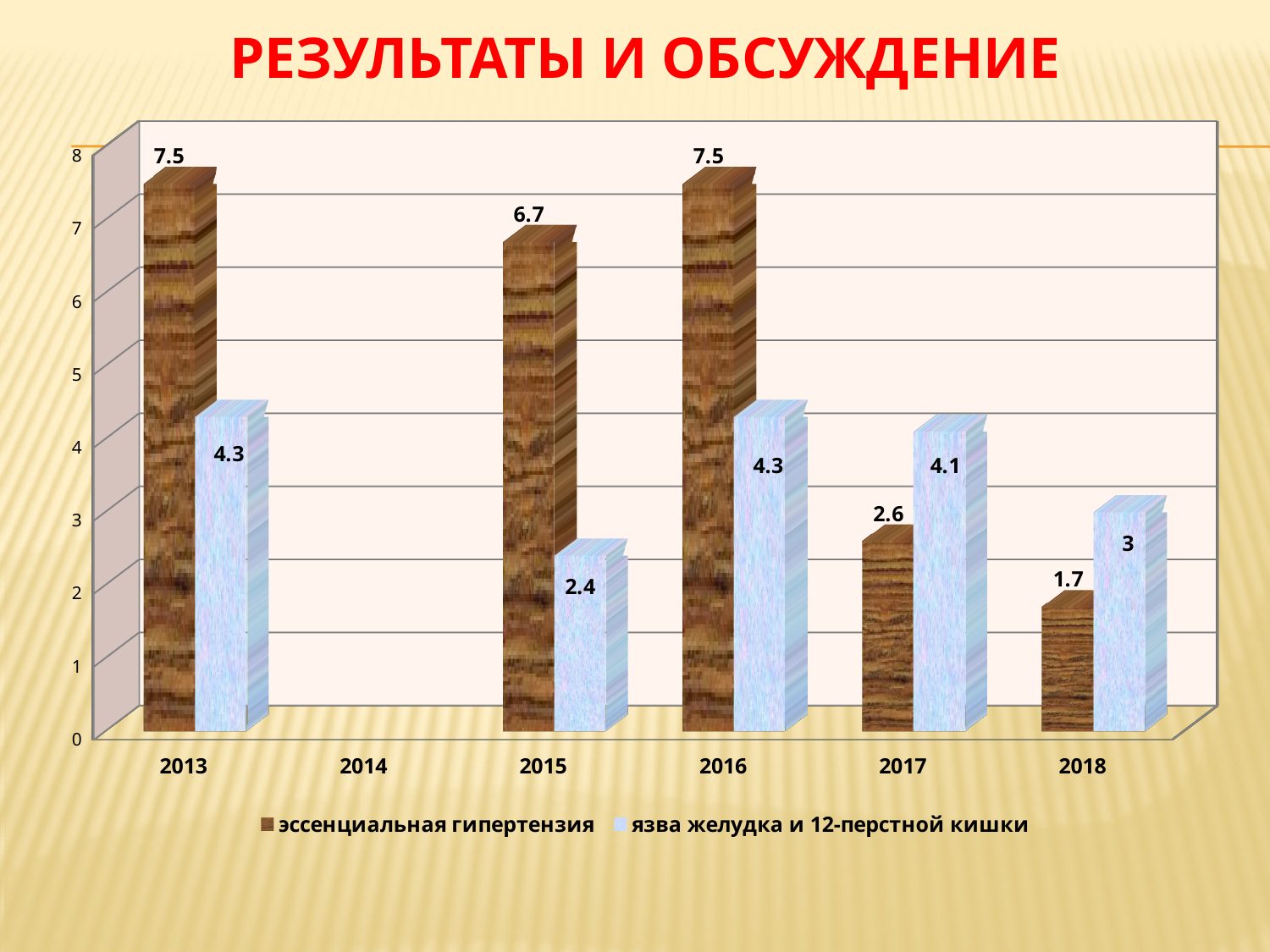
How many years are labelled on the x axis? 6 In 2017, which series has the larger value? язва желудка и 12-перстной кишки What is the difference between the two series' values in 2013? 3.2 What kind of chart is shown on the slide? bar chart How many series does the legend list? 2 What is the difference between the эссенциальная гипертензия values in 2016 and 2017? 4.9 What is the value for эссенциальная гипертензия in 2018? 1.7 What is the value for язва желудка и 12-перстной кишки in 2017? 4.1 What is the value for язва желудка и 12-перстной кишки in 2015? 2.4 In which year is the value for эссенциальная гипертензия lowest? 2018 In which year is the value for язва желудка и 12-перстной кишки lowest? 2015 What is the value for эссенциальная гипертензия in 2015? 6.7